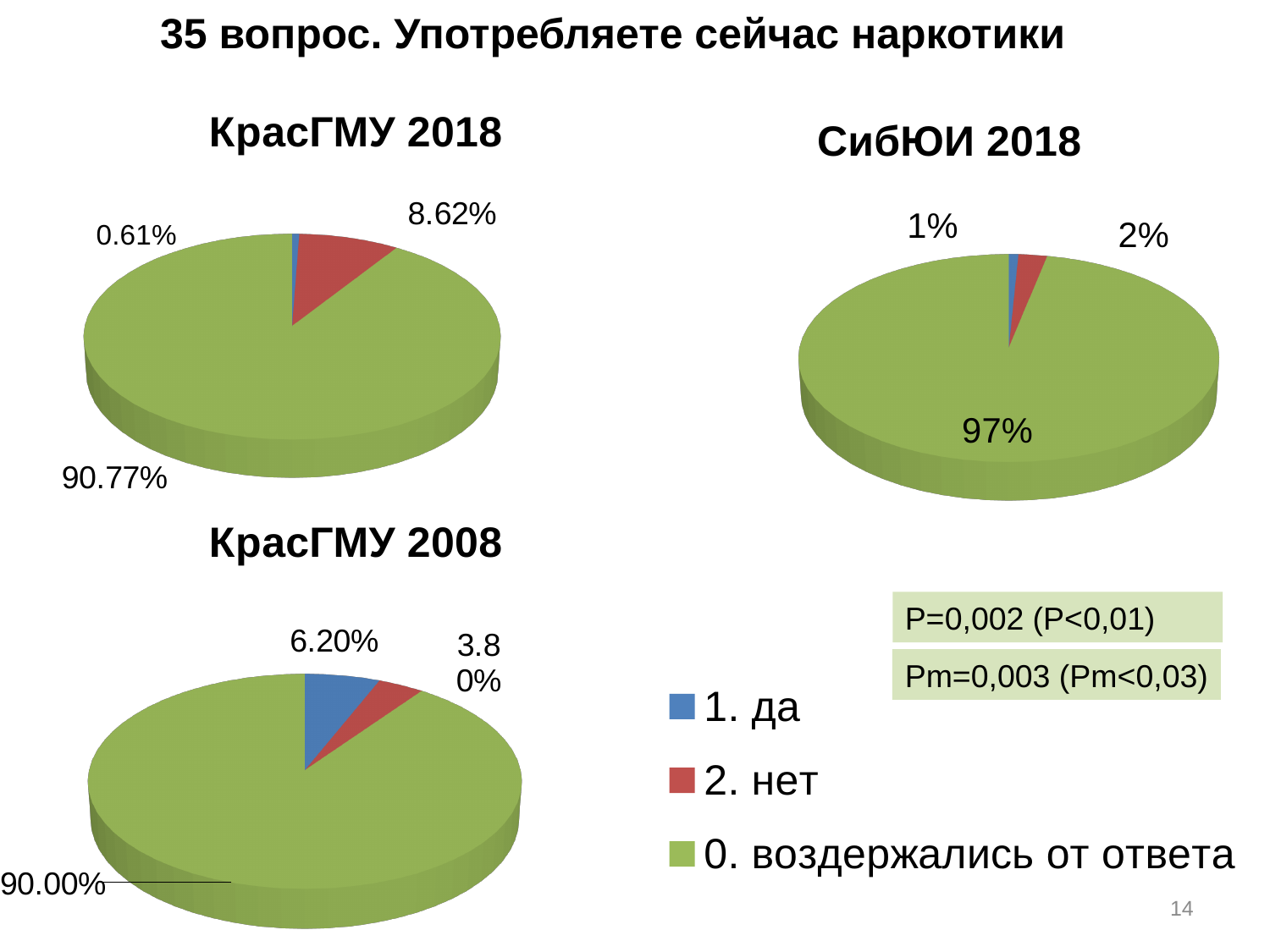
In the КрасГМУ 2008 chart, what share of respondents chose "0. воздержались от ответа"? 90.00% In the КрасГМУ 2008 chart, which answer has the smallest slice? 2. нет What type of chart is used for КрасГМУ 2018? Pie chart In the СибЮИ 2018 chart, what share of respondents answered "2. нет"? 2% In the СибЮИ 2018 chart, what share of respondents chose "0. воздержались от ответа"? 97% In the КрасГМУ 2018 chart, what share of respondents answered "2. нет"? 8.62% In the КрасГМУ 2018 chart, which answer has the largest slice? 0. воздержались от ответа In the КрасГМУ 2018 chart, what share of respondents answered "1. да"? 0.61% How many entries does the legend list? 3 In the КрасГМУ 2008 chart, which is larger: the share for "1. да" or the share for "2. нет"? 1. да In the КрасГМУ 2008 chart, what share of respondents answered "1. да"? 6.20% What is the difference between the "2. нет" share in КрасГМУ 2018 and the "2. нет" share in СибЮИ 2018? 6.62 percentage points